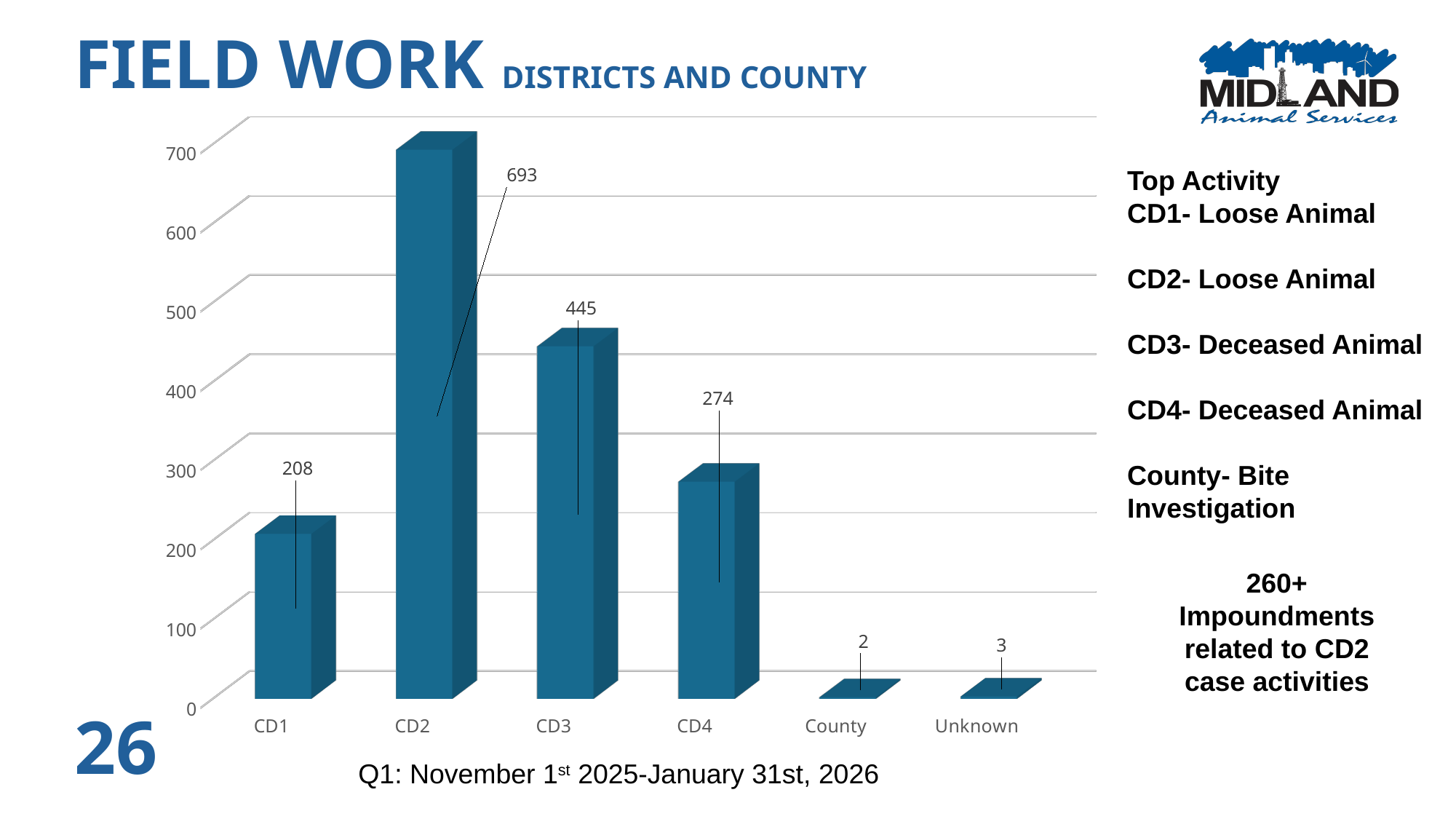
What period does the chart cover, according to the caption below it? Q1: November 1st 2025-January 31st, 2026 How many categories are shown on the x axis? 6 Which category has the highest value? CD2 Is the value for CD3 greater or less than 400? greater What is the difference between the values for CD1 and CD4? 66 What is the difference between the values for CD2 and CD3? 248 Which is larger, the value for CD1 or the value for CD3? CD3 What is the value for CD2? 693 What kind of chart is shown on the slide? bar chart What is the value for CD4? 274 What is the value for County? 2 Which category has the lowest value? County